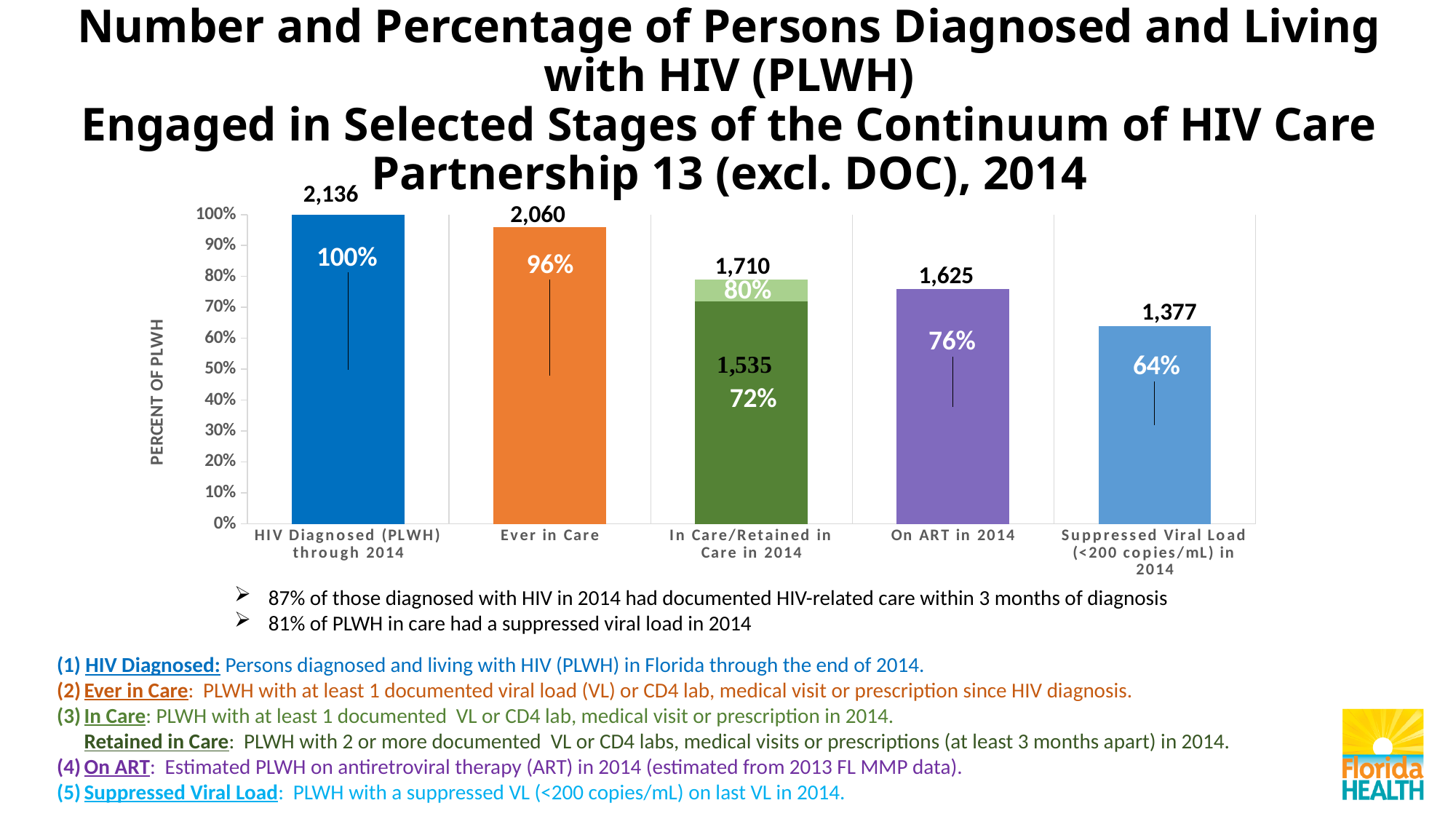
What kind of chart is shown on the slide? bar chart What is the difference in number of persons between 'HIV Diagnosed (PLWH) through 2014' and 'Ever in Care'? 76 What is the number of persons shown for the 'HIV Diagnosed (PLWH) through 2014' bar? 2,136 Which category has the highest value in the chart? HIV Diagnosed (PLWH) through 2014 What percentage is shown for 'Suppressed Viral Load (<200 copies/mL) in 2014'? 64% Which is larger, the number for 'On ART in 2014' or the number for 'Suppressed Viral Load (<200 copies/mL) in 2014'? On ART in 2014 What percentage is shown for the 'Ever in Care' bar? 96% What number is shown for persons retained in care in 2014 (the darker green portion of the 'In Care/Retained in Care in 2014' bar)? 1,535 Which category has the lowest value in the chart? Suppressed Viral Load (<200 copies/mL) in 2014 How many categories are shown on the x axis of the chart? 5 Do the bar values rise or fall moving from left to right across the chart? fall What number is shown for 'On ART in 2014'? 1,625